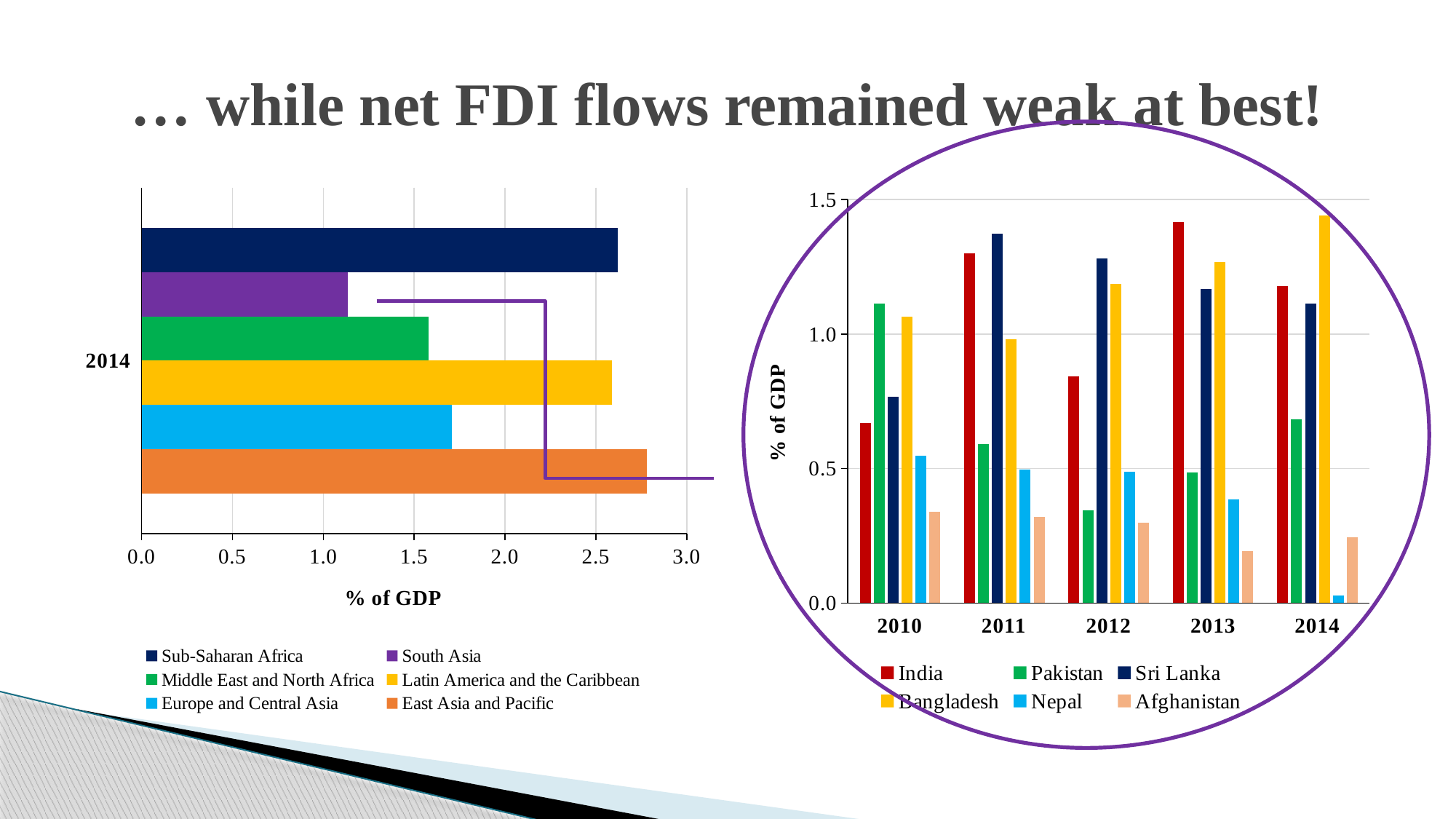
In the chart on the left, is the value for South Asia greater or less than 1.5? less What kind of chart is the chart on the left of the slide? bar chart How many countries does the legend of the chart on the right list? 6 In the chart on the right, which is larger in 2012, India or Pakistan? India In the chart on the left, which region has the lowest value? South Asia What is the label on the vertical axis of the chart on the right? % of GDP In the chart on the right, is the value for India in 2013 greater or less than 1.0? greater In the chart on the left, is the value for Sub-Saharan Africa greater or less than 2.5? greater In the chart on the right, do the values for Nepal rise or fall from 2010 to 2014? fall In the chart on the left, which region has the highest value? East Asia and Pacific How many regions are listed in the legend of the chart on the left? 6